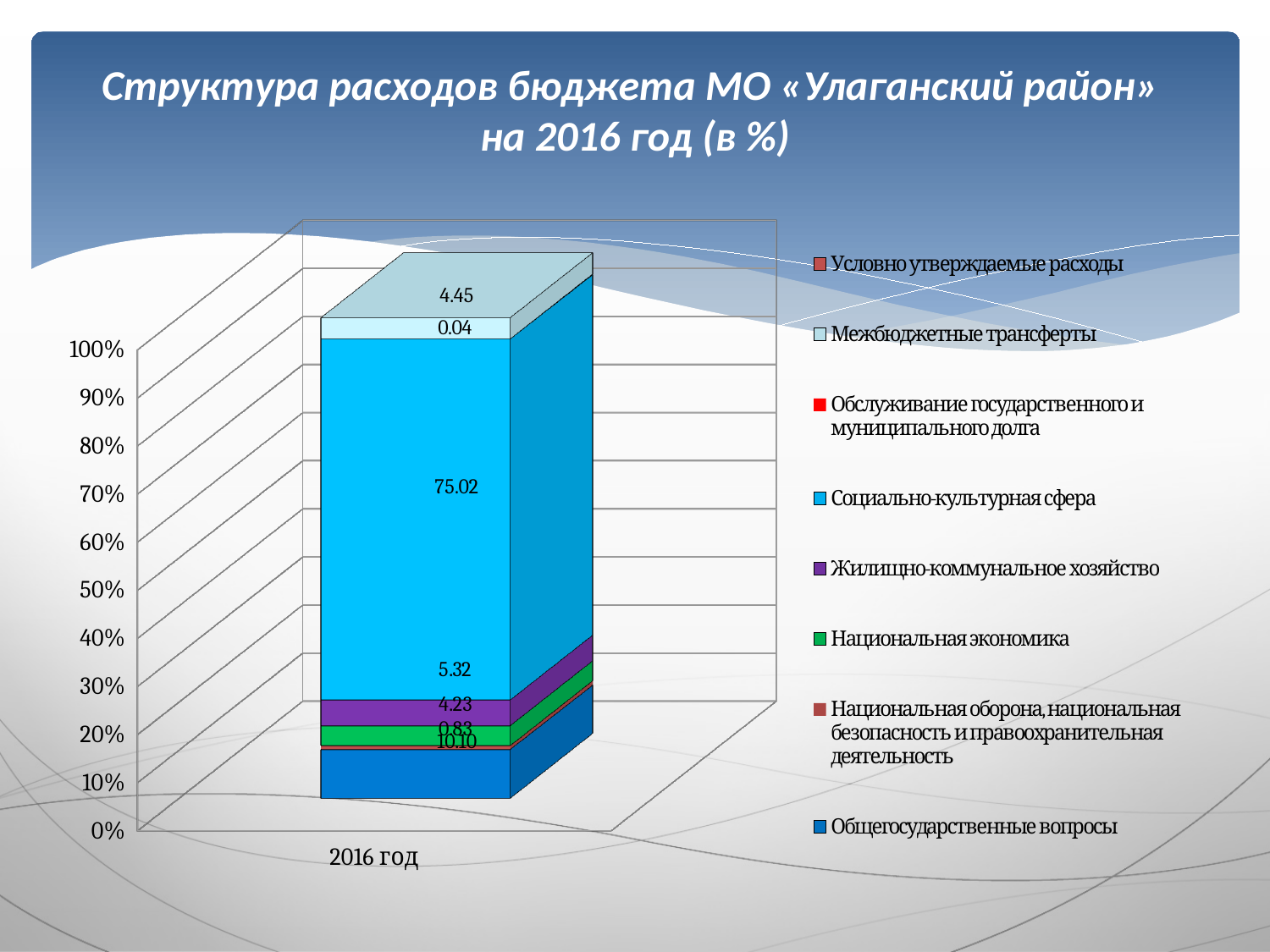
How many categories are shown on the x axis? 1 What kind of chart is shown on the slide? Stacked bar chart What is the difference between the values for Социально-культурная сфера and Общегосударственные вопросы? 64.92 What is the value for Общегосударственные вопросы? 10.10 Which is larger, the value for Жилищно-коммунальное хозяйство or for Национальная экономика? Жилищно-коммунальное хозяйство What value is shown for Жилищно-коммунальное хозяйство? 5.32 Which expenditure category has the largest share of the 2016 год bar? Социально-культурная сфера What value is labelled for Межбюджетные трансферты? 4.45 What is the value shown for Социально-культурная сфера in the 2016 год bar? 75.02 What value is labelled for Национальная экономика? 4.23 What is the value for Обслуживание государственного и муниципального долга? 0.04 How many series does the legend list? 8